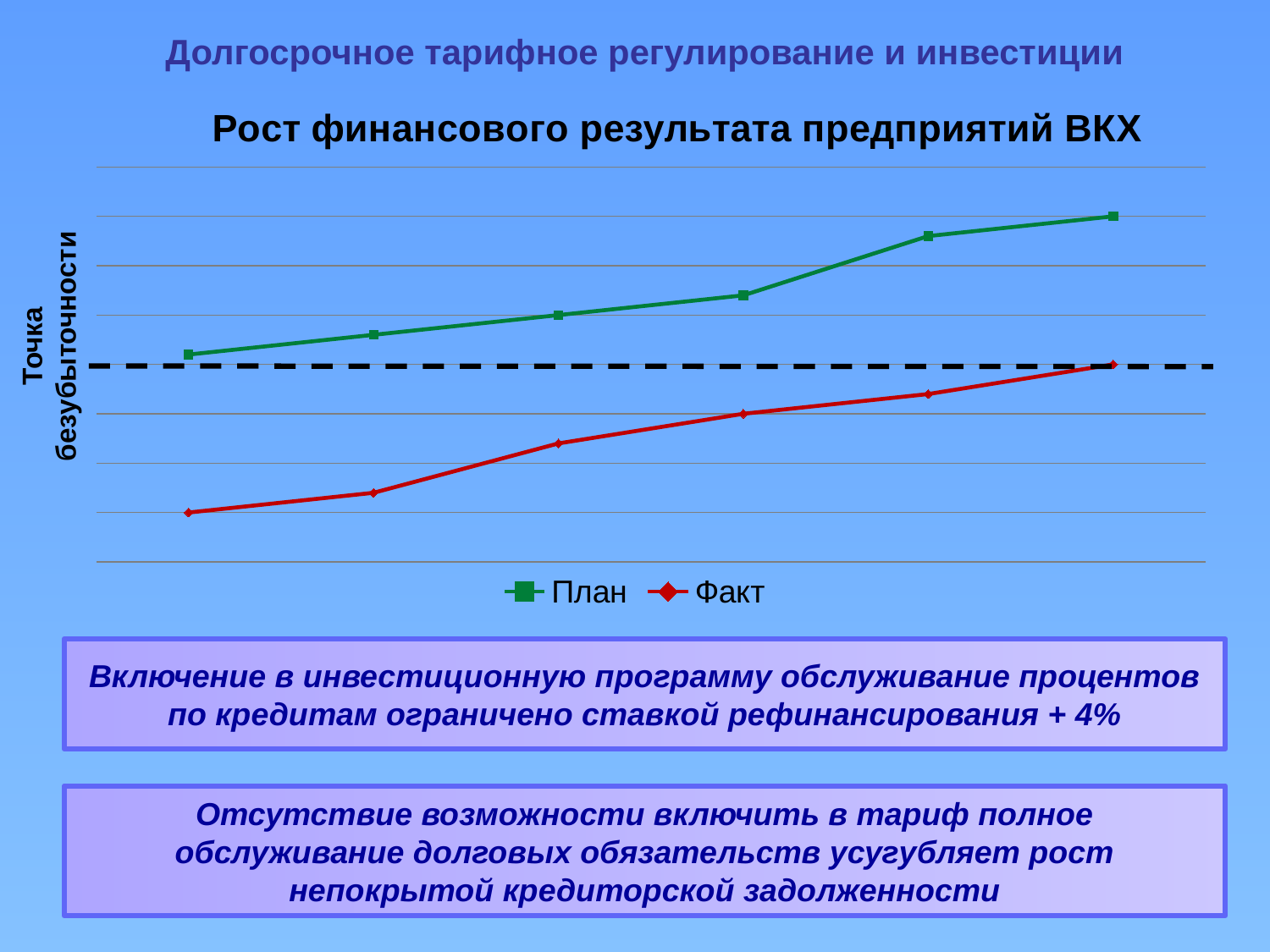
How many data points does the Факт series have? 6 What colour is the line for the Факт series? red Do the values of the План series rise or fall along the x axis? rise What is the title of the chart? Рост финансового результата предприятий ВКХ How many data points does the План series have? 6 Which series is higher at the first point, План or Факт? План How many series does the legend list? 2 What kind of chart is shown on the slide? line chart Which series is higher at the last point, План or Факт? План Do the values of the Факт series rise or fall along the x axis? rise